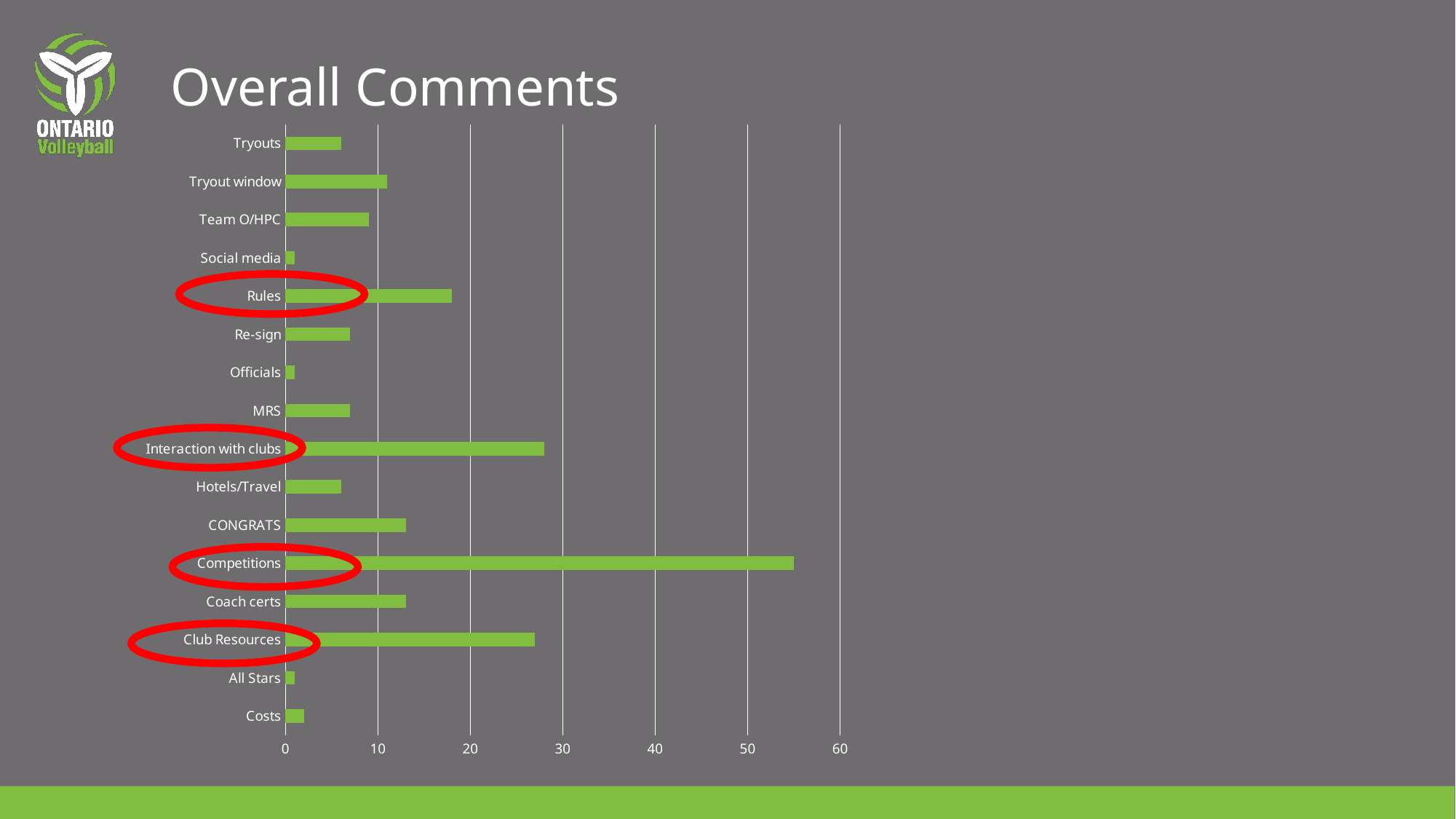
Is the value for Club Resources greater or less than 30? less Which has a larger value, Competitions or Interaction with clubs? Competitions Which has a larger value, Rules or CONGRATS? Rules Which category has the highest value in the chart? Competitions How many category labels are circled in red on the chart? 4 How many categories are plotted in the chart? 16 Is the value for Costs greater or less than 10? less Is the value for Competitions greater or less than 50? greater What is the title of the chart on the slide? Overall Comments What kind of chart is shown on the slide? Bar chart